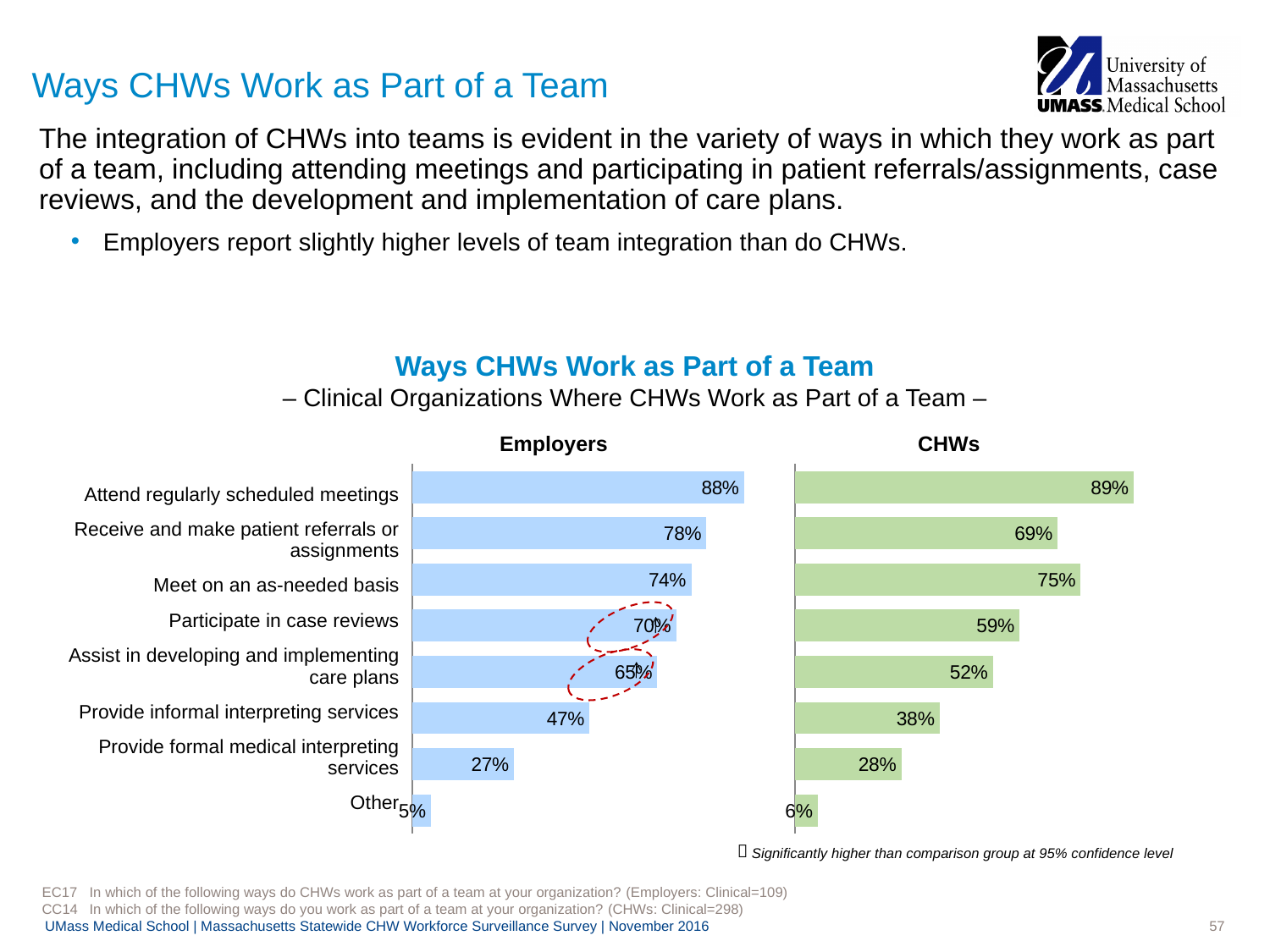
In the Employers chart, which category has the lowest value? Other In the CHWs chart, what percentage of CHWs report participating in case reviews? 59% In the Employers chart, what is the value for 'Provide formal medical interpreting services'? 27% What is the difference between the Employers value and the CHWs value for 'Participate in case reviews'? 11 percentage points What type of chart is used to show the Employers data? Bar chart In the CHWs chart, which category has the highest value? Attend regularly scheduled meetings In the CHWs chart, what is the value for 'Provide informal interpreting services'? 38% In the Employers chart, what percentage of employers report that CHWs attend regularly scheduled meetings? 88% How many categories are shown in the Employers chart? 8 For 'Meet on an as-needed basis', which is larger: the Employers value or the CHWs value? CHWs What is the difference between the Employers value and the CHWs value for 'Assist in developing and implementing care plans'? 13 percentage points For 'Receive and make patient referrals or assignments', which is larger: the Employers value or the CHWs value? Employers